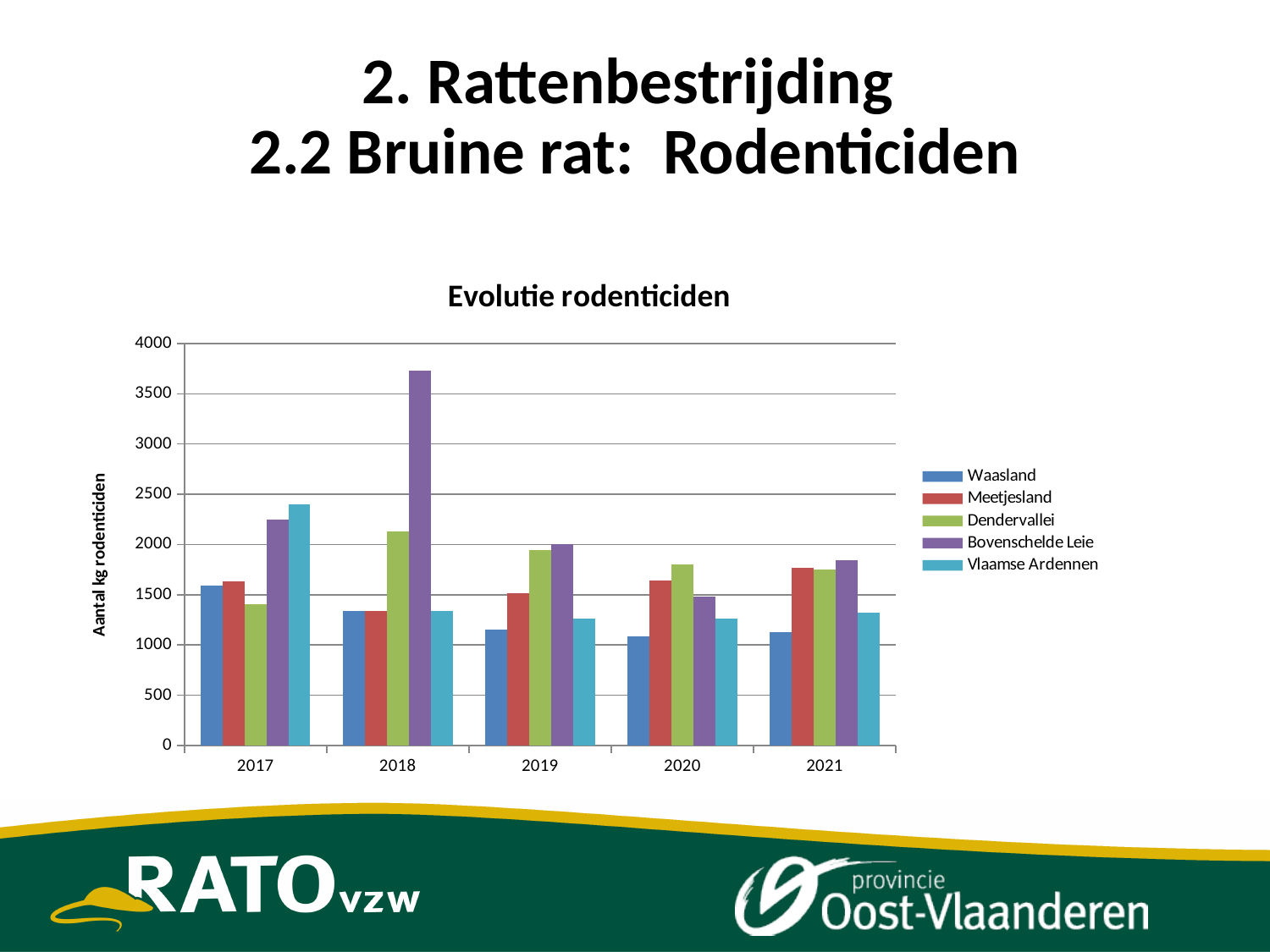
What kind of chart is shown on the slide? bar chart Which series has the highest value in 2018? Bovenschelde Leie How many series does the legend list? 5 What is the label on the y axis? Aantal kg rodenticiden How many years are shown on the x axis? 5 Is the value for Dendervallei in 2018 greater or less than 2000? greater In 2017, which is larger: Vlaamse Ardennen or Dendervallei? Vlaamse Ardennen Do the values for Waasland rise or fall from 2017 to 2020? fall Is the value for Waasland in 2020 greater or less than 1500? less Which series has the lowest value in 2020? Waasland What is the title of the chart? Evolutie rodenticiden Is the value for Bovenschelde Leie in 2018 greater or less than 3500? greater